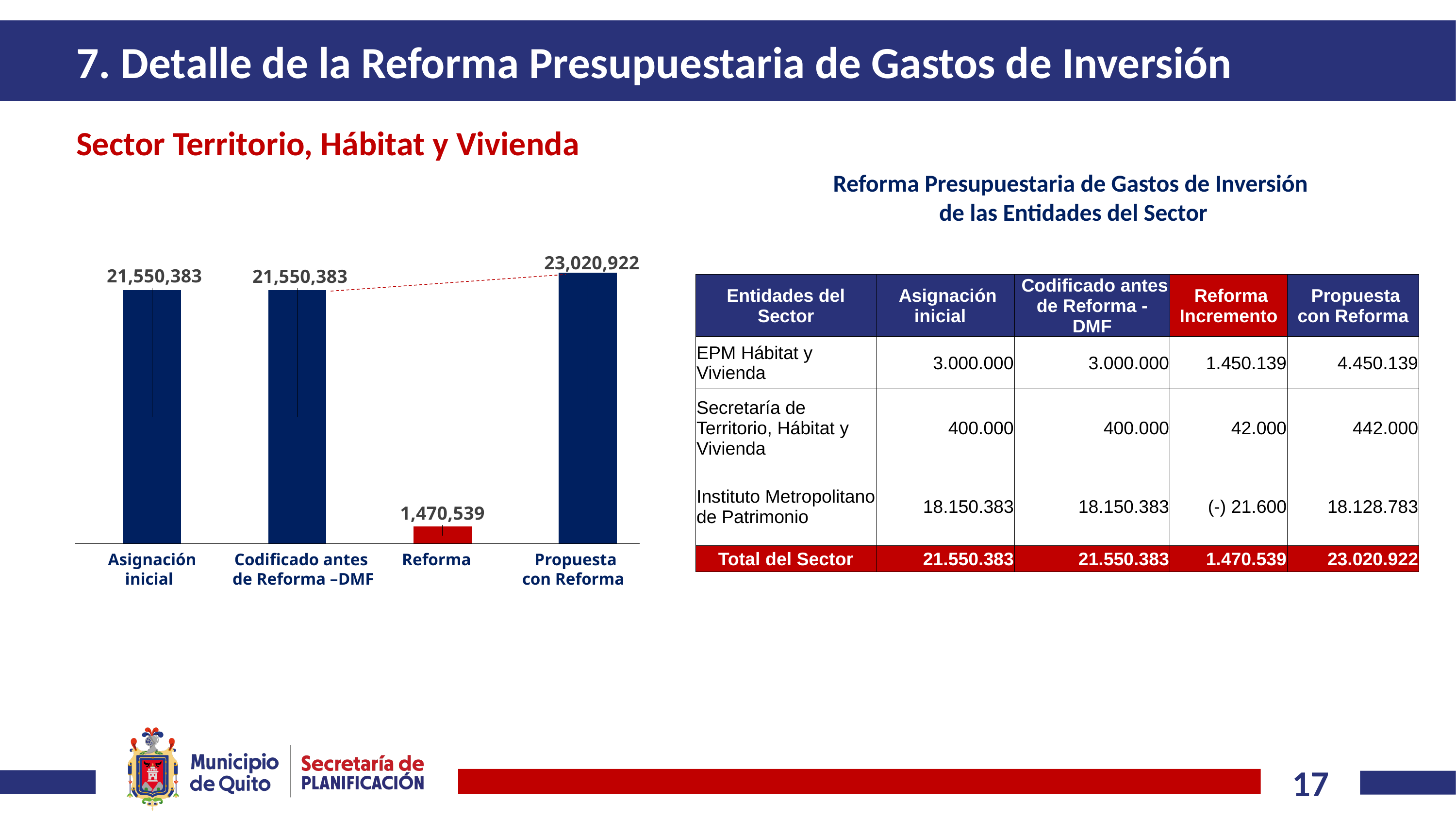
What is the value of the Asignación inicial bar? 21,550,383 Which is larger, the Propuesta con Reforma bar or the Codificado antes de Reforma –DMF bar? Propuesta con Reforma What is the difference between the Asignación inicial bar and the Reforma bar? 20,079,844 What is the value of the Propuesta con Reforma bar? 23,020,922 What is the value of the Reforma bar? 1,470,539 What type of chart is shown on the slide? Bar chart Which category has the highest value in the chart? Propuesta con Reforma What is the value of the Codificado antes de Reforma –DMF bar? 21,550,383 What colour is the Reforma bar? Red How many bars are shown in the chart? 4 What is the difference between the Propuesta con Reforma bar and the Asignación inicial bar? 1,470,539 Which category has the lowest value in the chart? Reforma